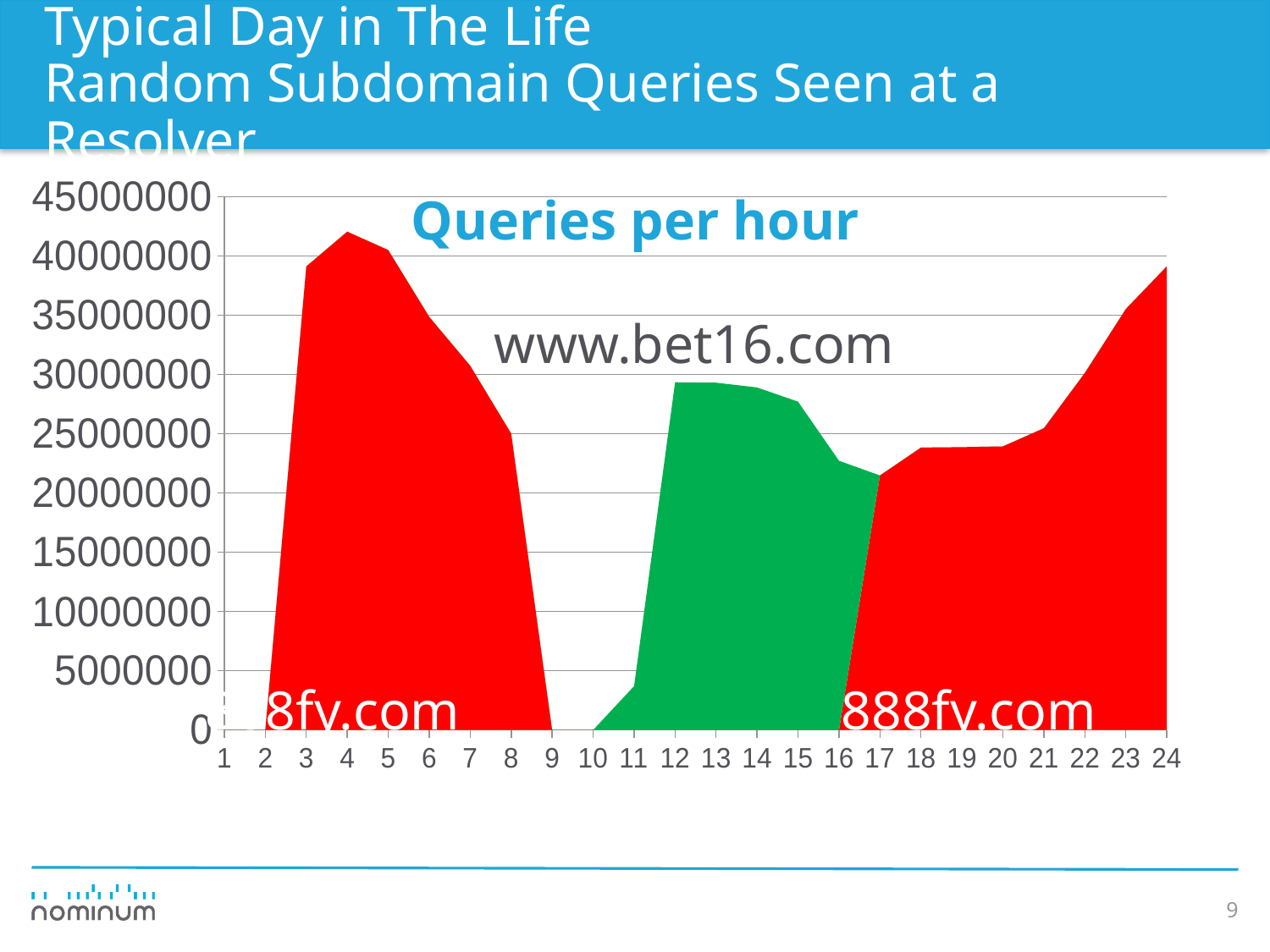
At which hour does the chart reach its highest value? 4 How many hours are marked along the x axis of the chart? 24 Which hour has the larger value, hour 12 or hour 18? hour 12 Do the values rise or fall from hour 17 to hour 24? rise Is the value at hour 11 greater or less than 5000000? less Is the value at hour 24 greater or less than 35000000? greater What is the title of the chart? Queries per hour Which hour has the larger value, hour 4 or hour 24? hour 4 Is the value at hour 17 greater or less than 20000000? greater What kind of chart is shown on the slide? area chart What colour is the area labelled www.bet16.com? green